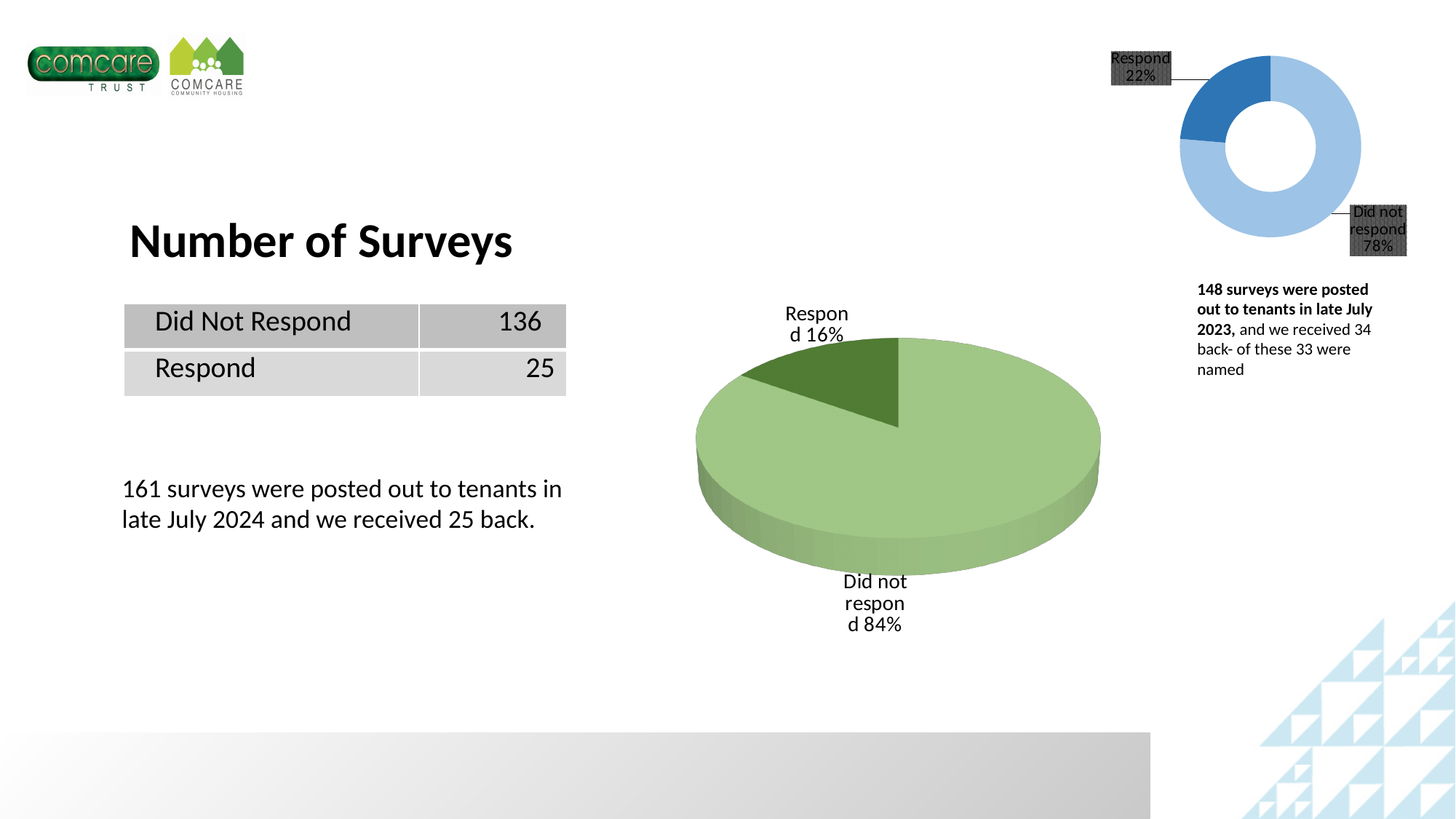
On the small blue doughnut chart in the top right of the slide, what share is labelled for Respond? 22% What kind of chart is the small blue chart in the top right of the slide? Doughnut chart On the large green pie chart in the centre of the slide, how many slices are there? 2 On the small blue doughnut chart in the top right of the slide, what share is labelled for Did not respond? 78% What kind of chart is the large green chart in the centre of the slide? Pie chart On the large green pie chart in the centre of the slide, what is the difference in percentage points between Did not respond and Respond? 68 percentage points On the large green pie chart in the centre of the slide, which slice is the smallest? Respond On the large green pie chart in the centre of the slide, what share is labelled for Respond? 16% On the large green pie chart in the centre of the slide, what colour is the Respond slice? Dark green On the small blue doughnut chart in the top right of the slide, which segment is larger, Respond or Did not respond? Did not respond On the large green pie chart in the centre of the slide, which slice is the largest? Did not respond